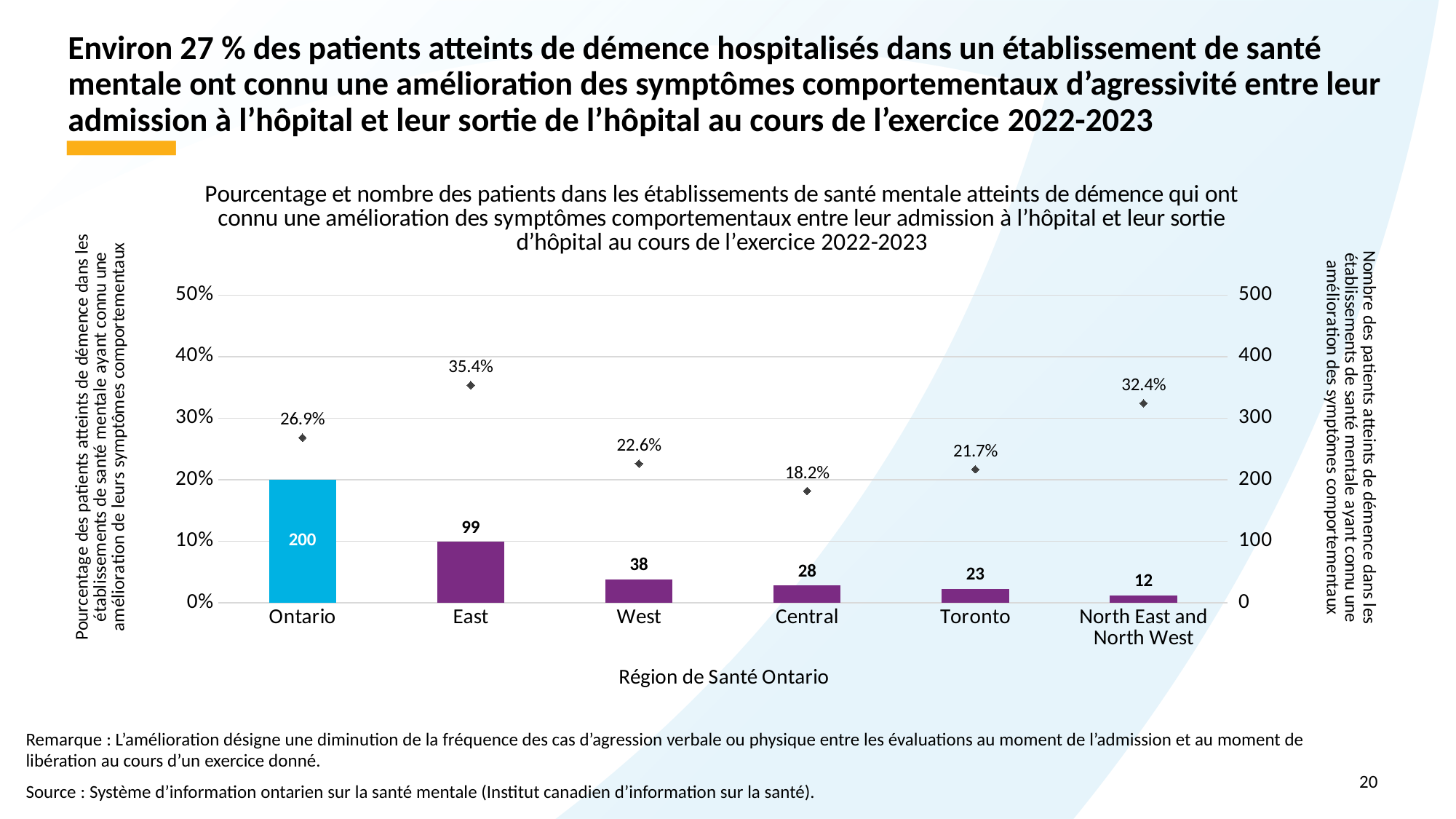
What is the difference in the number of patients between the East and West regions? 61 What is the number of patients with improved behavioural symptoms for Ontario? 200 Which region has the smallest number of patients with improved behavioural symptoms? North East and North West What kind of chart is used to show the number of patients in each region? Bar chart Which region has the highest percentage of patients with improved behavioural symptoms? East What is the label of the x axis of the chart? Région de Santé Ontario How many regions are shown on the x axis of the chart? 6 What is the percentage of patients with improved behavioural symptoms for the East region? 35.4% Which has a higher percentage of patients with improved behavioural symptoms, West or Central? West What is the percentage of patients with improved behavioural symptoms for Toronto? 21.7% What is the number of patients with improved behavioural symptoms for the North East and North West region? 12 Which region has the lowest percentage of patients with improved behavioural symptoms? Central